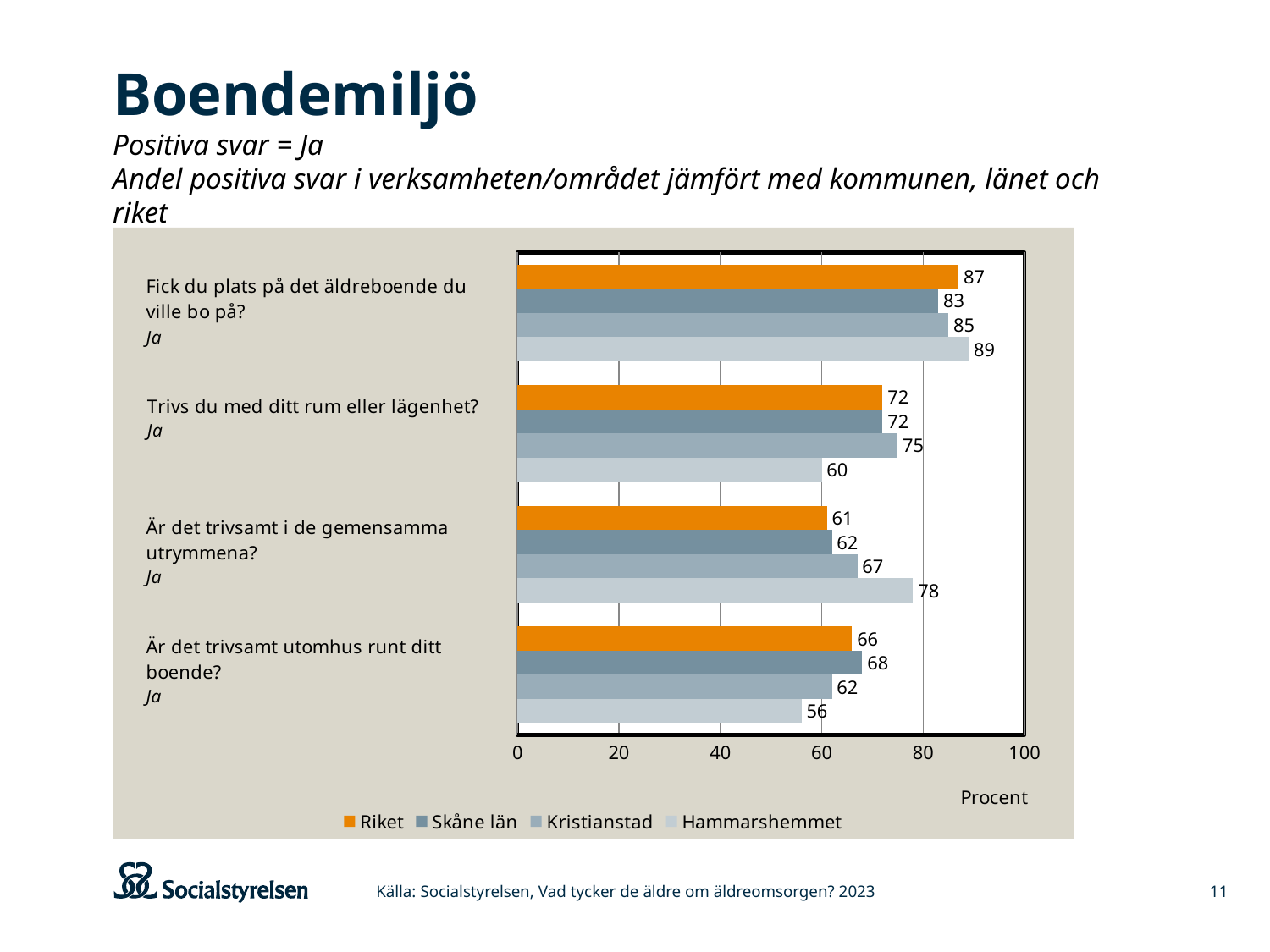
Which is larger for "Fick du plats på det äldreboende du ville bo på?": Riket or Skåne län? Riket What is the value for Skåne län for "Är det trivsamt utomhus runt ditt boende?" 68 What is the value for Kristianstad for "Är det trivsamt i de gemensamma utrymmena?" 67 What is the difference between the Kristianstad and Hammarshemmet values for "Trivs du med ditt rum eller lägenhet?" 15 What is the value for Hammarshemmet for "Fick du plats på det äldreboende du ville bo på?" 89 How many questions (categories) are shown on the chart? 4 What is the value for Riket for "Trivs du med ditt rum eller lägenhet?" 72 Which series has the lowest value for "Är det trivsamt utomhus runt ditt boende?" Hammarshemmet Is the Hammarshemmet value for "Är det trivsamt utomhus runt ditt boende?" greater or less than 60? less How many series does the legend list? 4 What kind of chart is shown on the slide? bar chart Which series has the highest value for "Är det trivsamt i de gemensamma utrymmena?" Hammarshemmet